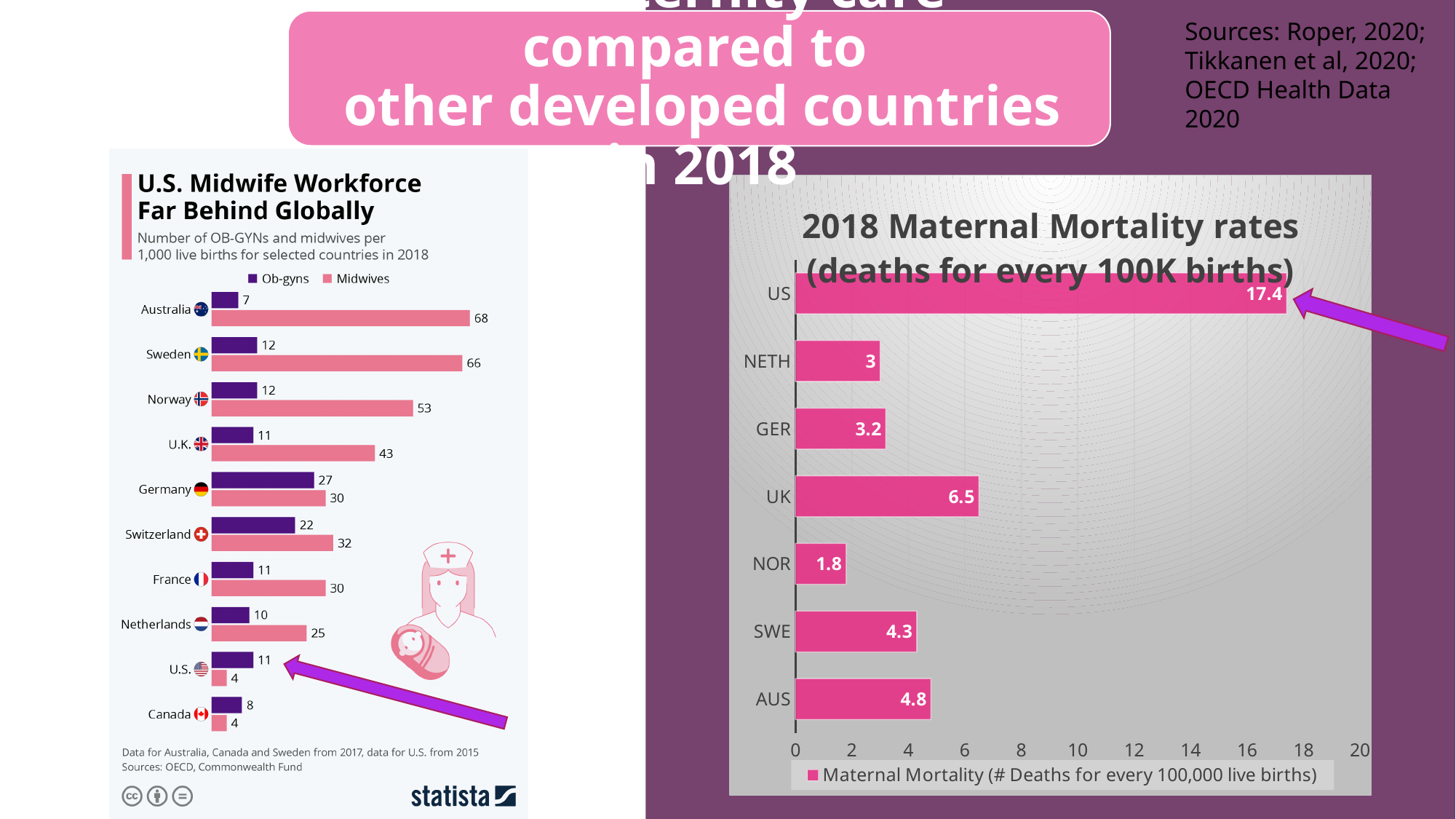
In the 2018 Maternal Mortality rates chart, which country has the lowest maternal mortality rate? NOR How many series does the legend of the U.S. Midwife Workforce Far Behind Globally chart list? 2 In the 2018 Maternal Mortality rates chart, what is the difference between the UK and SWE values? 2.2 In the 2018 Maternal Mortality rates chart, how many countries are shown? 7 In the 2018 Maternal Mortality rates chart, what is the value for the US? 17.4 In the U.S. Midwife Workforce Far Behind Globally chart, which country has the highest number of Ob-gyns? Germany In the U.S. Midwife Workforce Far Behind Globally chart, how many Ob-gyns per 1,000 live births does Germany have? 27 In the 2018 Maternal Mortality rates chart, which is larger, the value for GER or the value for AUS? AUS In the U.S. Midwife Workforce Far Behind Globally chart, how many countries are shown? 10 In the U.S. Midwife Workforce Far Behind Globally chart, how many midwives per 1,000 live births does Australia have? 68 In the U.S. Midwife Workforce Far Behind Globally chart, what is the difference between the midwives values for Sweden and the U.S.? 62 What kind of chart is the 2018 Maternal Mortality rates chart? Bar chart